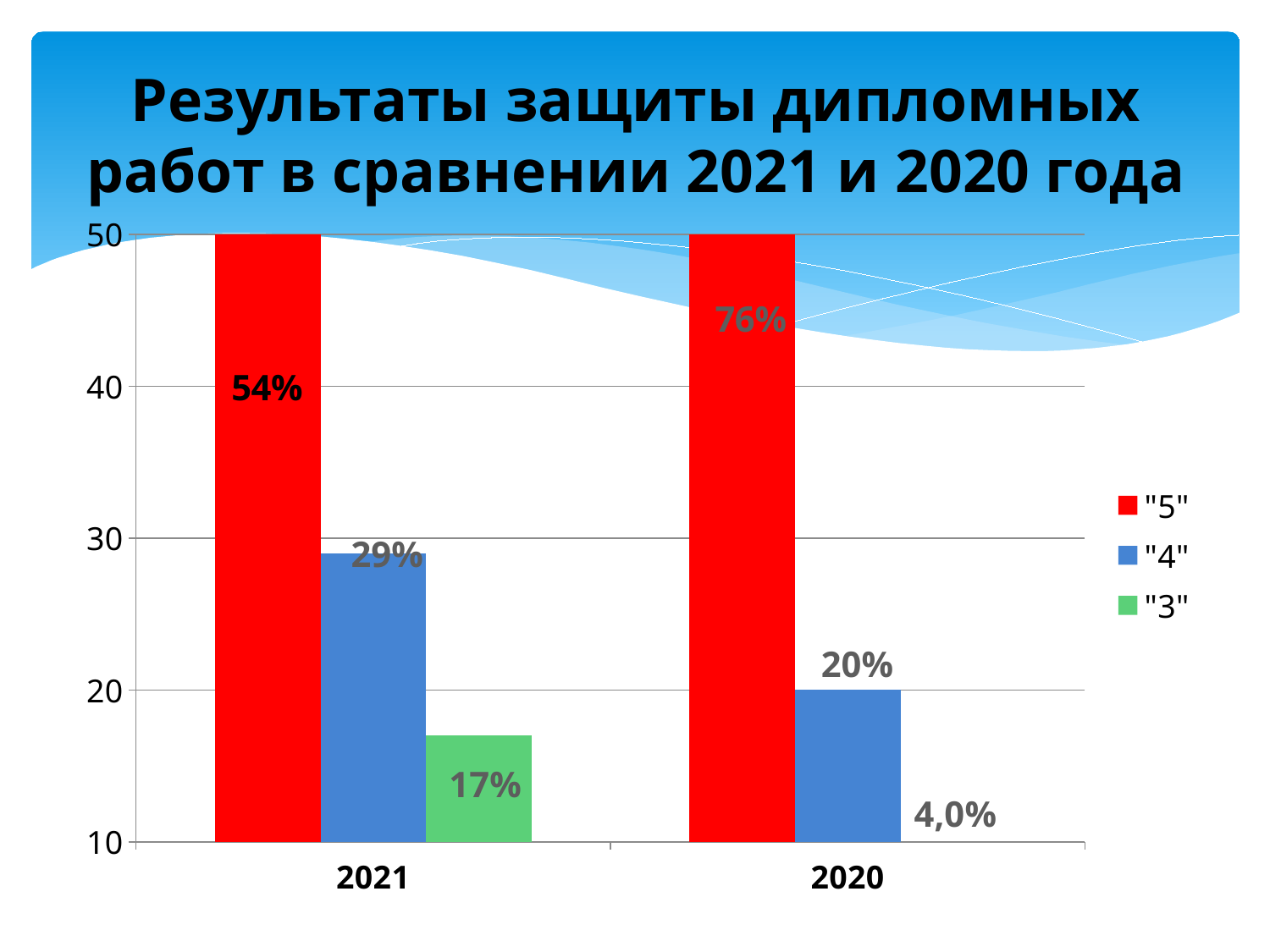
What is the difference between the "5" values for 2020 and 2021? 22% Which series has the highest value in 2020? "5" Which series has the lowest value in 2021? "3" What is the value for "3" in 2020? 4,0% How many categories are shown on the x axis? 2 What is the value for "4" in 2021? 29% What is the value for "3" in 2021? 17% What kind of chart is shown on the slide? Bar chart How many series does the legend list? 3 What is the value for "5" in 2020? 76% Which is larger, the "4" value in 2021 or the "4" value in 2020? 2021 What is the value for "5" in 2021? 54%